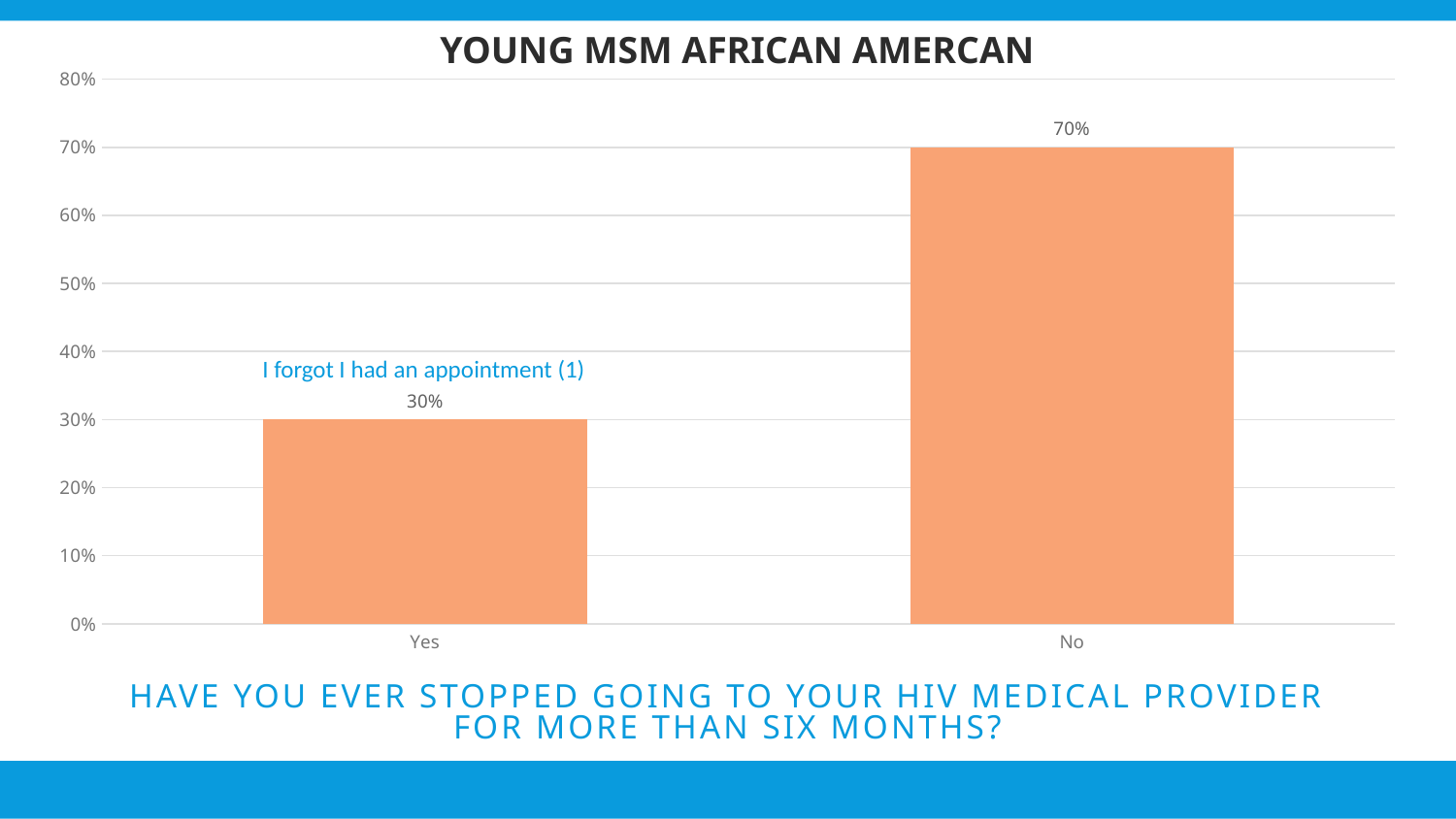
What is the difference between the values for No and Yes? 40% What is the value for No? 70% Is the value for No greater or less than 60%? greater What is the title of the chart? YOUNG MSM AFRICAN AMERCAN Is the value for Yes greater or less than 40%? less What kind of chart is shown on the slide? bar chart Which category has the highest value? No Which category has the lowest value? Yes Which is larger, the value for Yes or the value for No? No What text annotation appears above the Yes bar? I forgot I had an appointment (1) How many categories are shown on the x axis? 2 What is the value for Yes? 30%